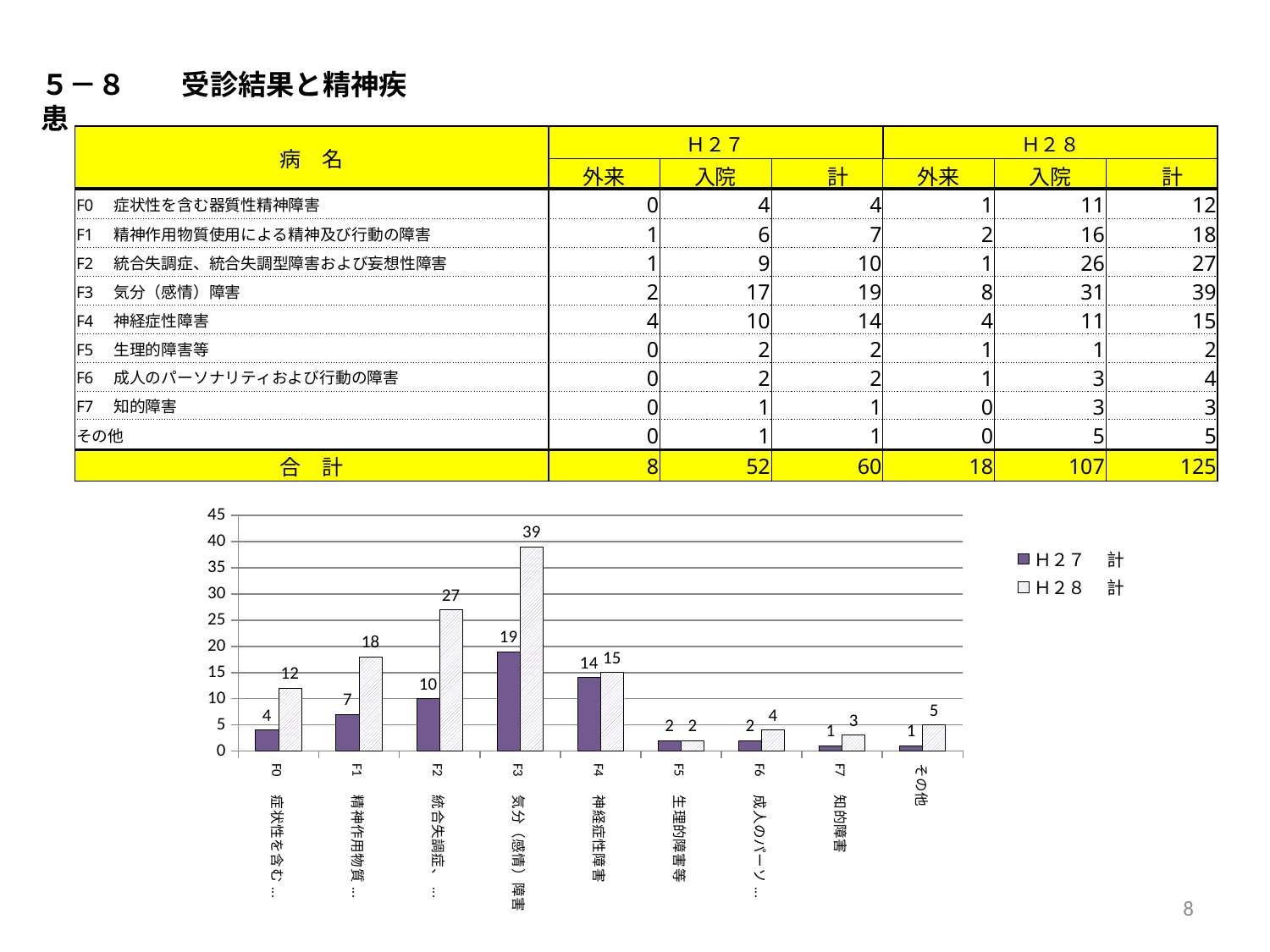
In the chart, what is the H28 計 value for F3 気分（感情）障害? 39 Which category has the highest H27 計 value in the chart? F3 気分（感情）障害 How many series does the chart legend list? 2 In the chart, what is the difference between the H28 計 and H27 計 values for F2 統合失調症? 17 In the chart, what is the difference between the H28 計 and H27 計 values for F0? 8 What type of chart is shown on the slide? bar chart In the chart, which is larger for F4 神経症性障害: the H27 計 value or the H28 計 value? H28 計 In the chart, which series is drawn with solid purple bars? H27 計 Which category has the highest H28 計 value in the chart? F3 気分（感情）障害 In the chart, what is the H28 計 value for その他? 5 In the chart, what is the H27 計 value for F2 統合失調症? 10 How many categories are plotted along the x axis of the chart? 9